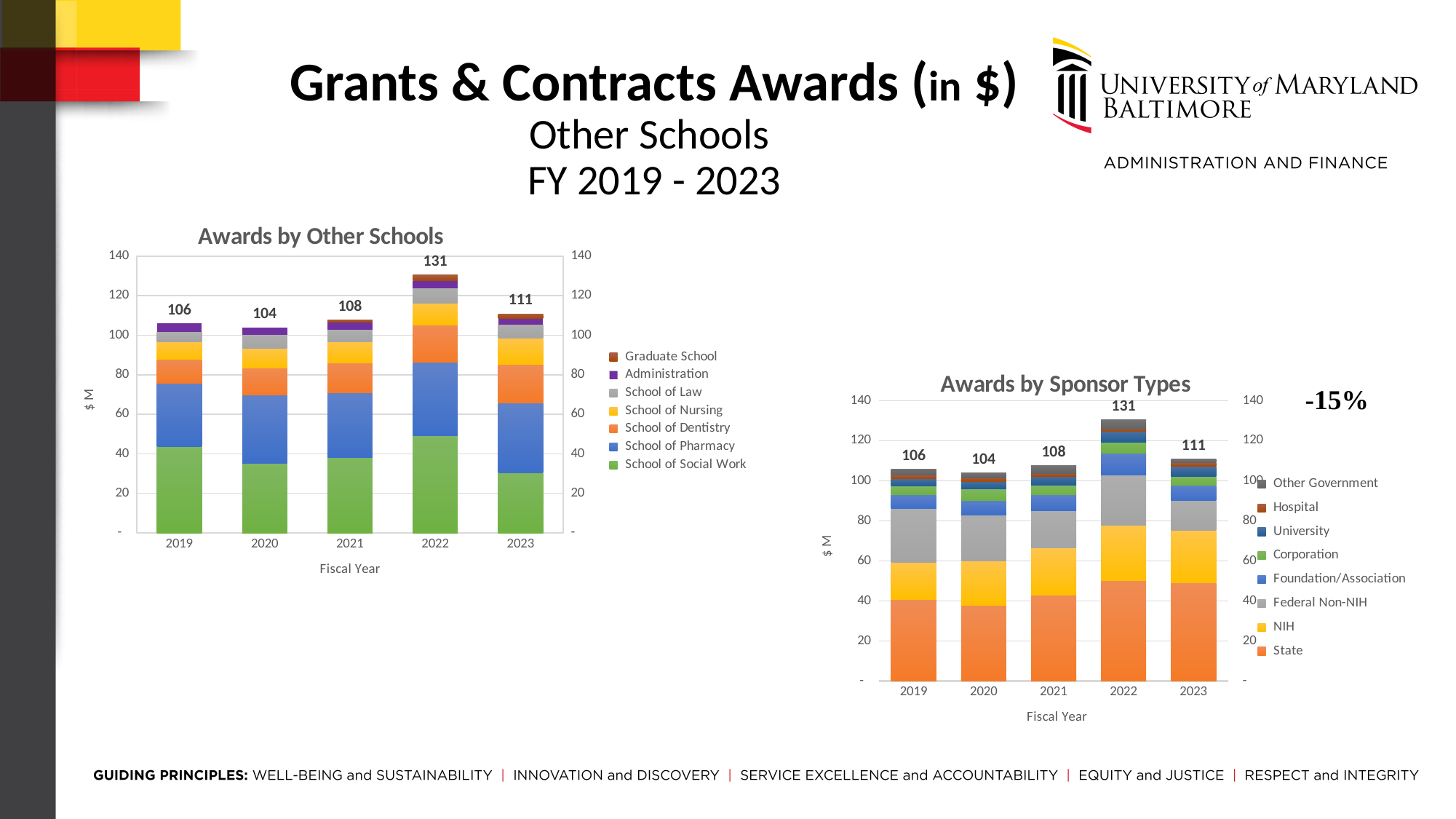
In the 'Awards by Other Schools' chart, is the School of Social Work segment for 2019 greater or less than 40? greater In the 'Awards by Sponsor Types' chart, which is larger, the total for 2019 or the total for 2021? 2021 In the 'Awards by Sponsor Types' chart, which fiscal year has the lowest total awards? 2020 What kind of chart is 'Awards by Other Schools'? Stacked bar chart In the 'Awards by Other Schools' chart, which fiscal year has the highest total awards? 2022 In the 'Awards by Other Schools' chart, what is the difference between the 2022 total and the 2023 total? 20 How many series does the legend of the 'Awards by Sponsor Types' chart list? 8 In the 'Awards by Other Schools' chart, what is the total awards value labeled for 2022? 131 How many fiscal years are shown on the x axis of the 'Awards by Other Schools' chart? 5 In the 'Awards by Sponsor Types' chart, which series is shown at the bottom of each stacked bar? State In the 'Awards by Sponsor Types' chart, what is the total awards value labeled for 2020? 104 In the 'Awards by Sponsor Types' chart, is the State segment for 2022 greater or less than 40? greater